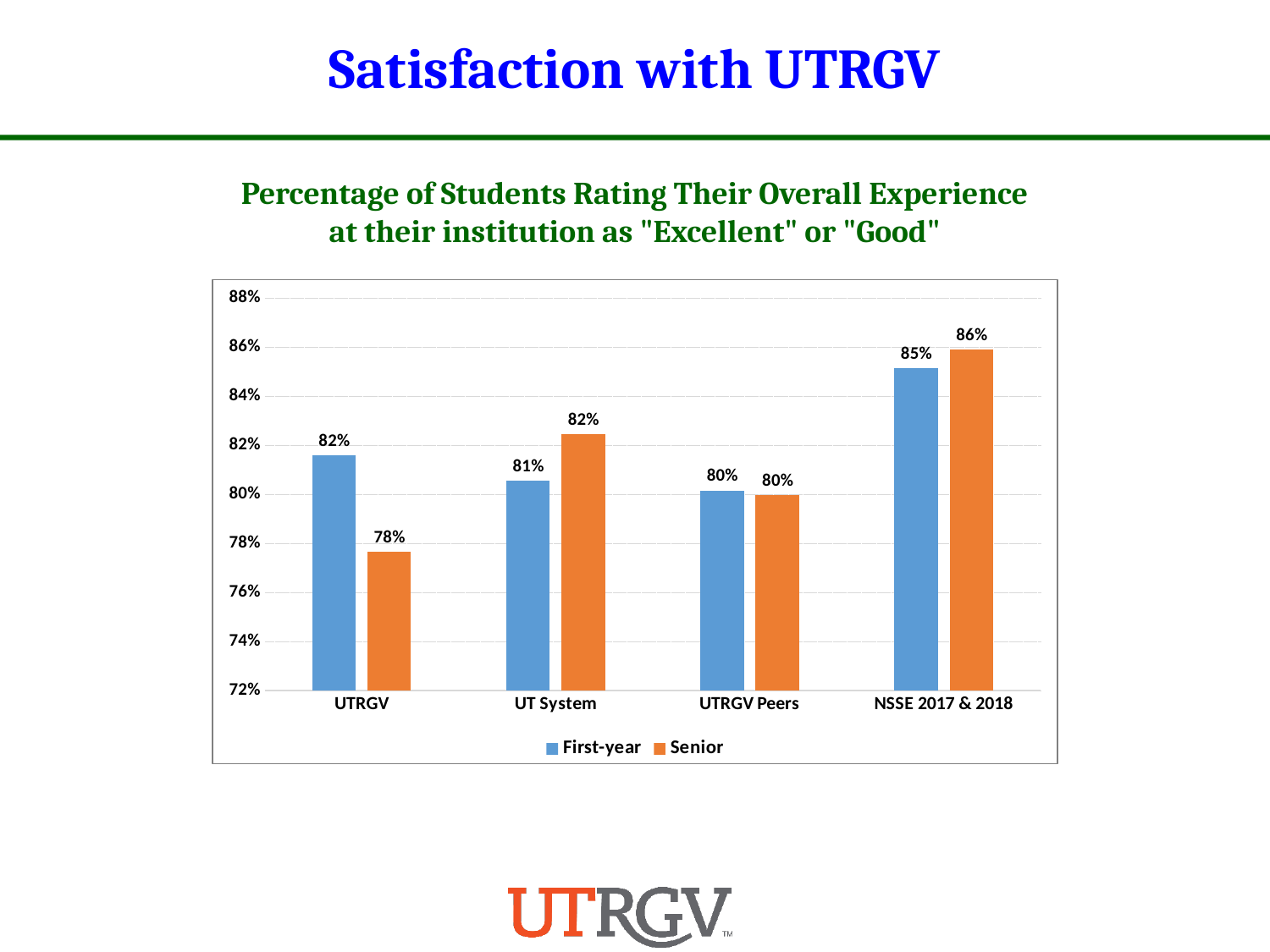
Which colour represents the Senior series? Orange What is the difference between the First-year and Senior values for UTRGV? 4% What is the Senior value for UT System? 82% What kind of chart is shown on the slide? Bar chart What is the First-year value for UTRGV? 82% For UT System, which is larger, the First-year value or the Senior value? Senior Which category has the highest Senior value? NSSE 2017 & 2018 What is the Senior value for UTRGV? 78% How many series does the legend list? 2 Which category has the lowest Senior value? UTRGV What is the First-year value for NSSE 2017 & 2018? 85% How many categories are shown on the x axis? 4